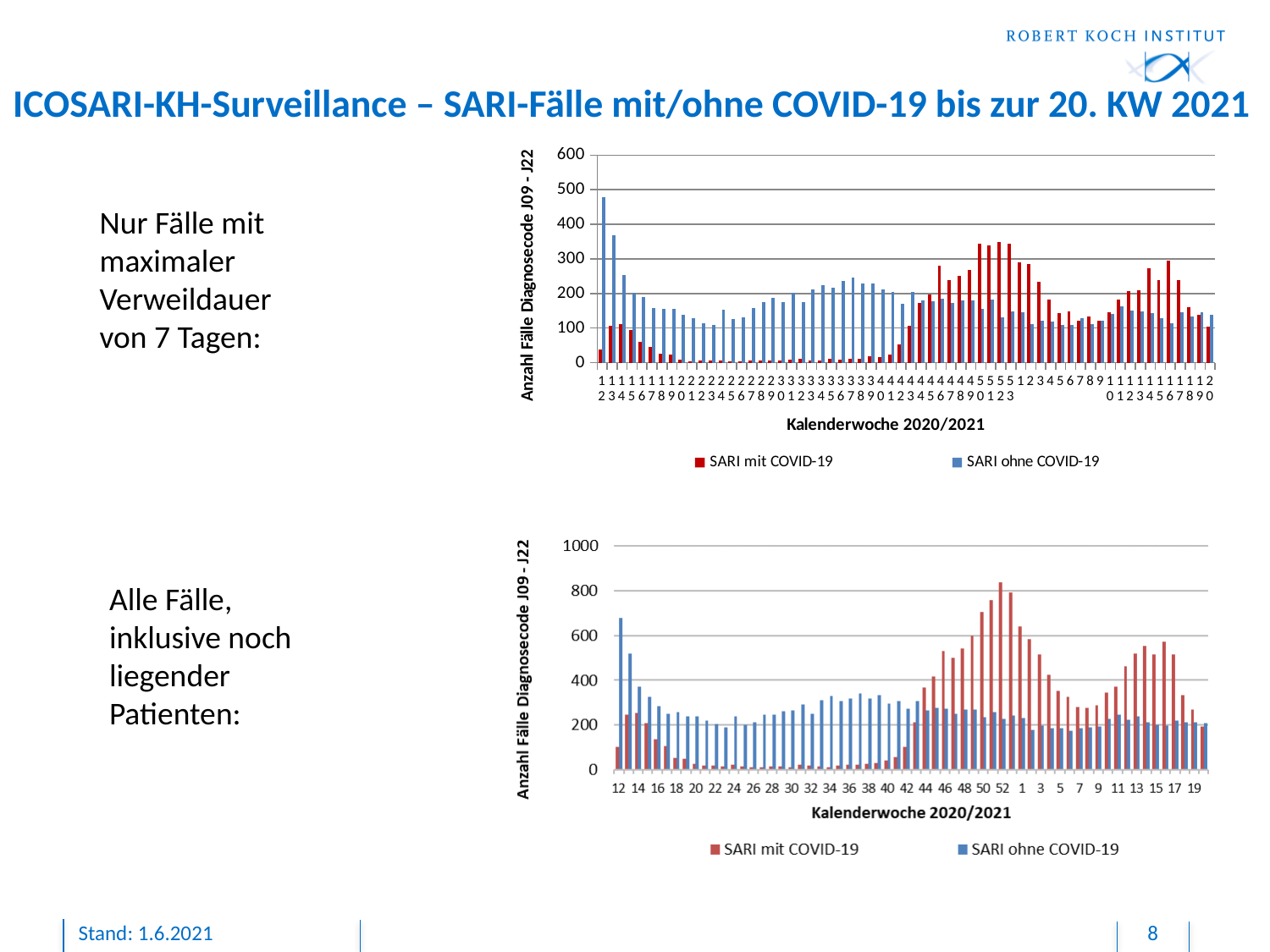
In the lower chart, is the highest value for SARI mit COVID-19 (around calendar week 52) greater or less than 800? greater In the upper chart, is the value for SARI mit COVID-19 in calendar week 30 greater or less than 100? less What kind of chart is the upper chart on the slide? bar chart In the lower chart, is the value for SARI ohne COVID-19 in calendar week 12 greater or less than 600? greater What is the y-axis title of the lower chart? Anzahl Fälle Diagnosecode J09 - J22 How many series does the legend of the lower chart list? 2 In the upper chart, which series is shown in red? SARI mit COVID-19 In the lower chart, in calendar week 52, which series has the larger value: SARI mit COVID-19 or SARI ohne COVID-19? SARI mit COVID-19 In the lower chart, which series has the tallest bar overall? SARI mit COVID-19 In the lower chart, do the values for SARI mit COVID-19 rise or fall from calendar week 42 to calendar week 52? rise In the lower chart, in calendar week 12, which series has the larger value: SARI mit COVID-19 or SARI ohne COVID-19? SARI ohne COVID-19